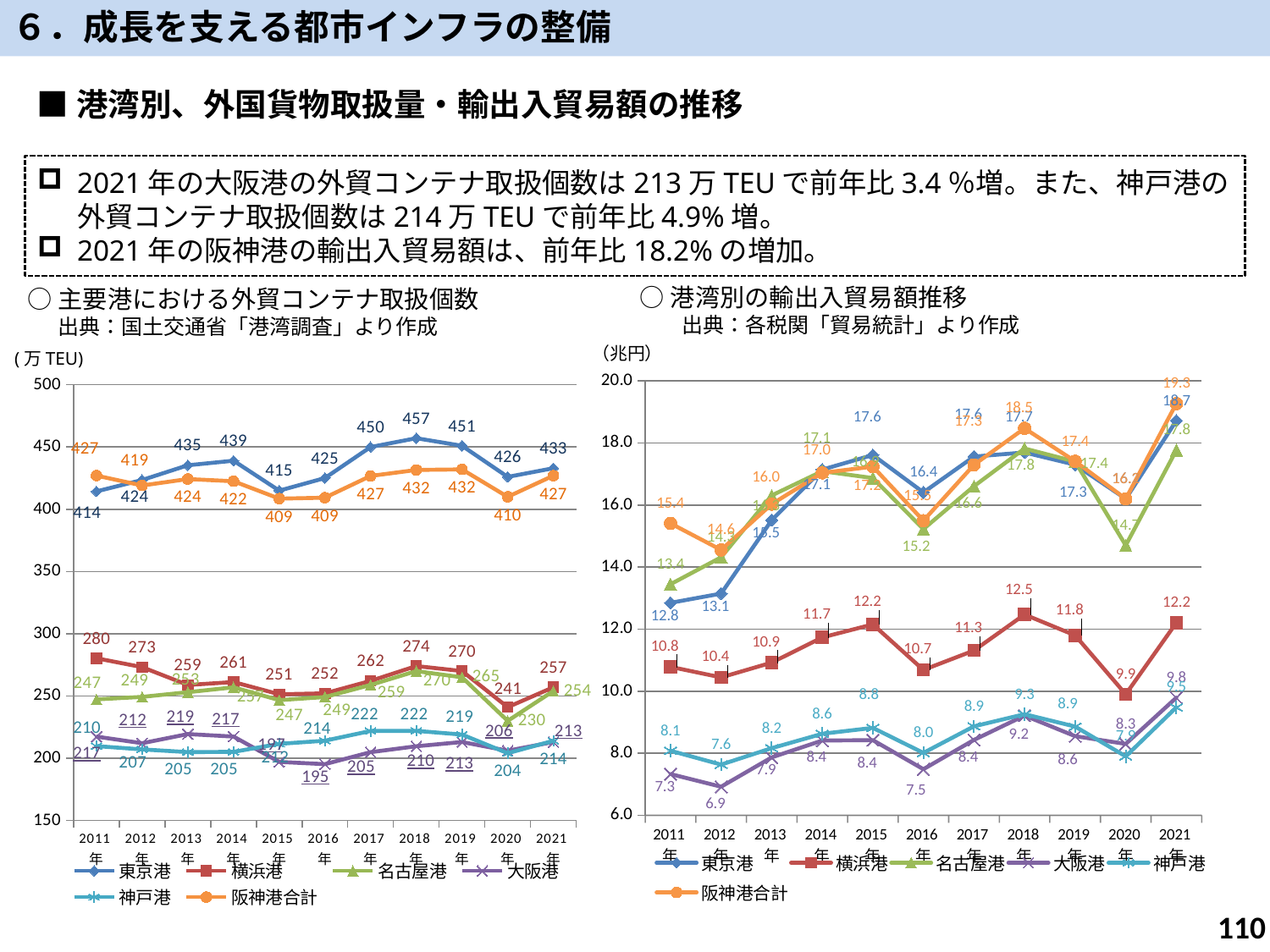
In the right chart (港湾別の輸出入貿易額推移), how many years are plotted on the x axis? 11 In the right chart (港湾別の輸出入貿易額推移), what is the value for 阪神港合計 in 2021? 19.3 In the right chart (港湾別の輸出入貿易額推移), what is the value for 大阪港 in 2012? 6.9 In the left chart (主要港における外貿コンテナ取扱個数), which year has the lowest value for 大阪港? 2016 In the left chart (主要港における外貿コンテナ取扱個数), what is the value for 東京港 in 2018? 457 In the left chart (主要港における外貿コンテナ取扱個数), what is the value for 横浜港 in 2011? 280 In the left chart (主要港における外貿コンテナ取扱個数), which is larger in 2020: 横浜港 or 名古屋港? 横浜港 In the right chart (港湾別の輸出入貿易額推移), which year has the highest value for 横浜港? 2018 In the left chart (主要港における外貿コンテナ取扱個数), how many series does the legend list? 6 In the left chart (主要港における外貿コンテナ取扱個数), what is the difference between 東京港 and 阪神港合計 in 2021? 6 In the right chart (港湾別の輸出入貿易額推移), what is the difference between 神戸港 in 2021 and 神戸港 in 2020? 1.6 What kind of chart is the right chart (港湾別の輸出入貿易額推移)? line chart